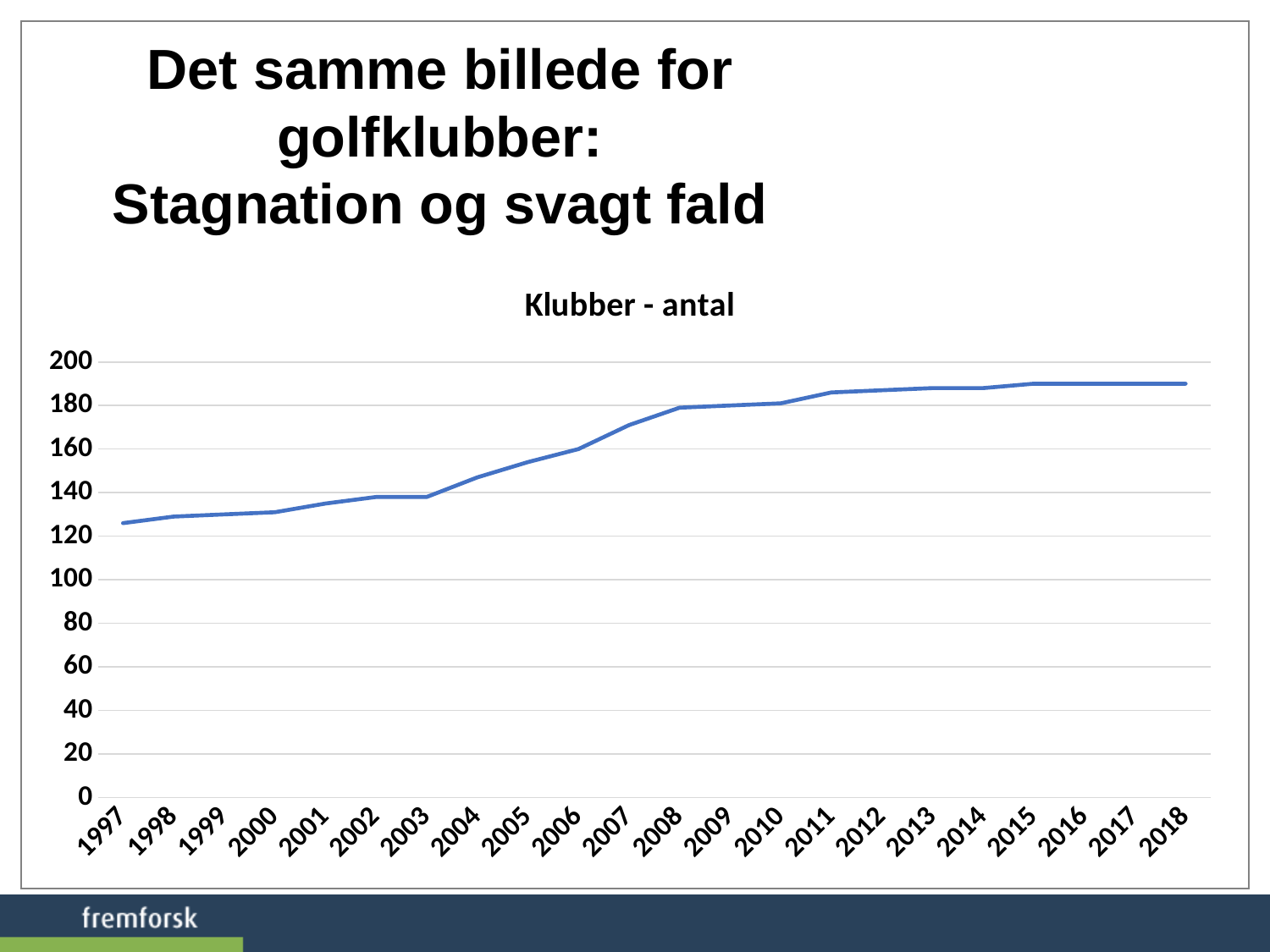
Which year has the larger value, 2001 or 2007? 2007 What is the title of the chart? Klubber - antal Is the value for 2018 greater or less than 180? greater Do the values generally rise or fall from 1997 to 2018? rise Is the value for 2004 greater or less than 140? greater Is the value for 1997 greater or less than 140? less How many years are plotted along the x axis? 22 What kind of chart is shown on the slide? line chart What is the highest value shown on the y axis? 200 Which year has the lowest number of clubs? 1997